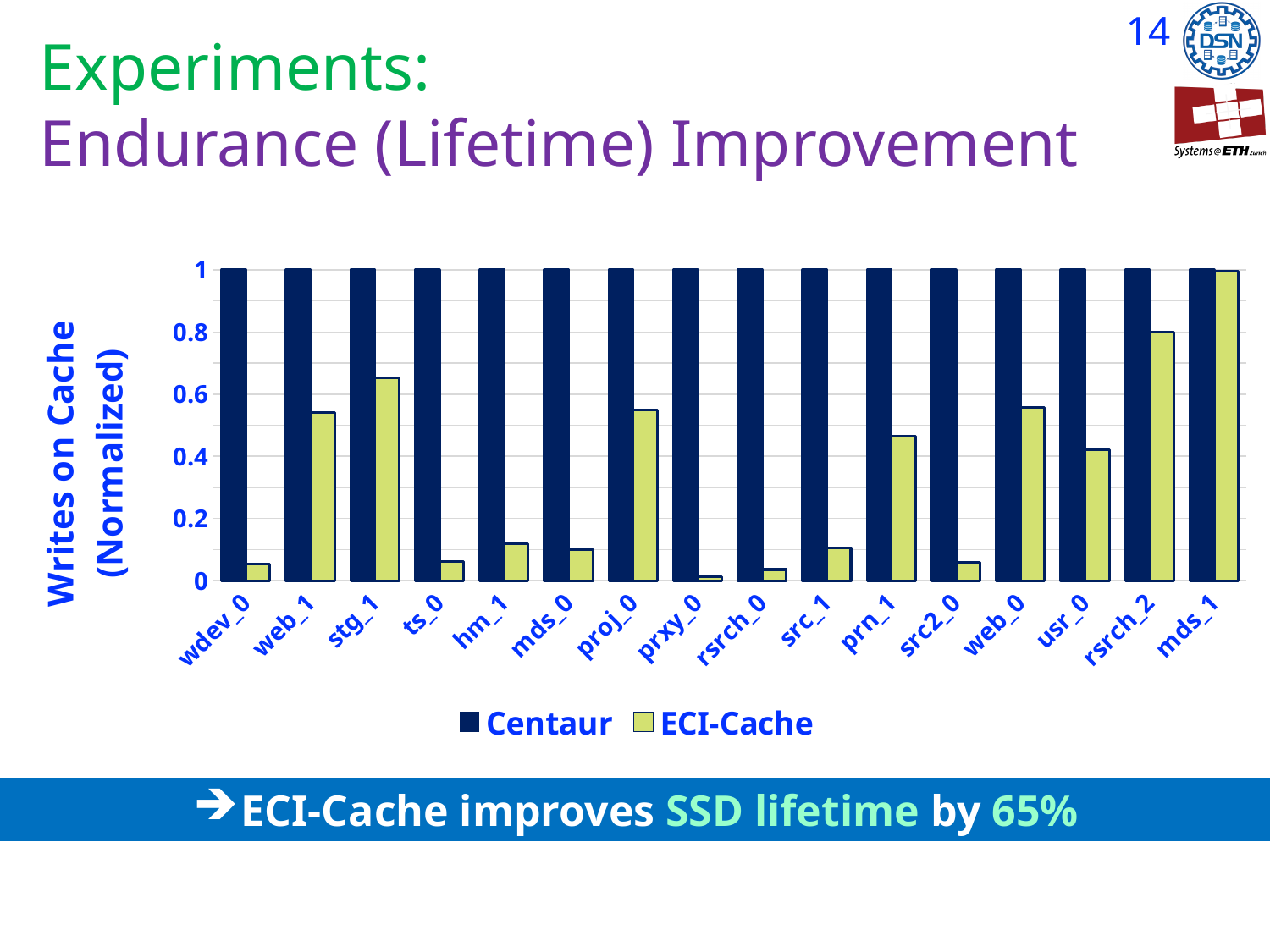
Is the ECI-Cache value for hm_1 greater or less than 0.2? less What is the normalized value of Centaur for wdev_0? 1 What kind of chart is shown on the slide? bar chart Which category has the highest ECI-Cache value? mds_1 Is the ECI-Cache value for stg_1 greater or less than 0.6? greater Is the ECI-Cache value for rsrch_2 greater or less than 0.6? greater Which has the larger ECI-Cache value, rsrch_2 or usr_0? rsrch_2 How many workload categories are shown on the x axis? 16 What is the label of the y axis? Writes on Cache (Normalized) Which category has the lowest ECI-Cache value? prxy_0 How many series does the legend list? 2 What is the normalized value of Centaur for mds_1? 1